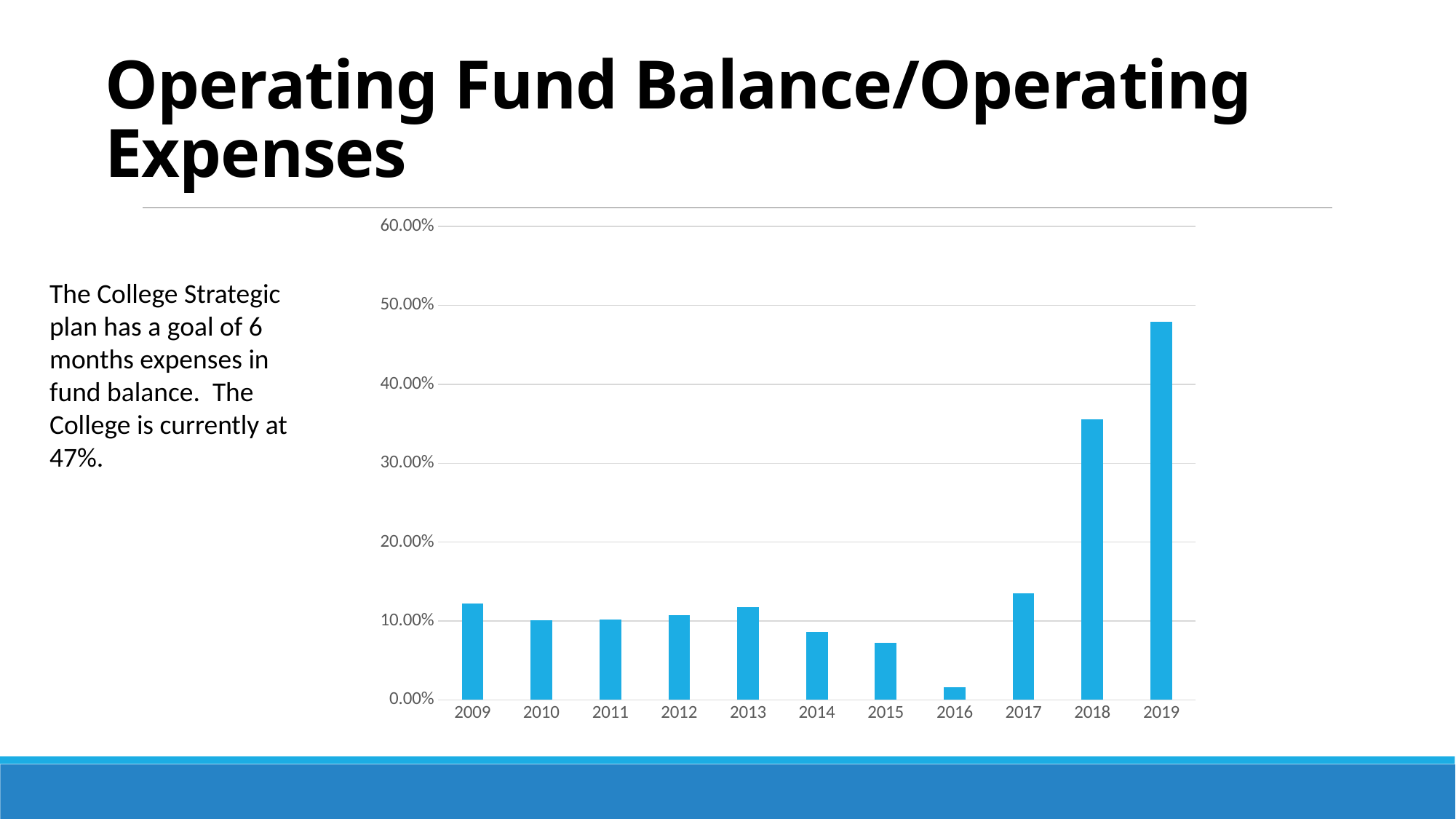
Is the value for 2016 greater or less than 10.00%? less Which year has the lowest bar in the chart? 2016 Which year has the highest bar in the chart? 2019 Do the values rise or fall from 2013 to 2016? fall Is the value for 2009 greater or less than 10.00%? greater Is the value for 2019 greater or less than 40.00%? greater Which year has the larger value, 2018 or 2017? 2018 How many years are plotted on the x axis of the chart? 11 Do the values rise or fall from 2016 to 2019? rise Which year has the larger value, 2009 or 2015? 2009 What kind of chart is shown on the slide? bar chart